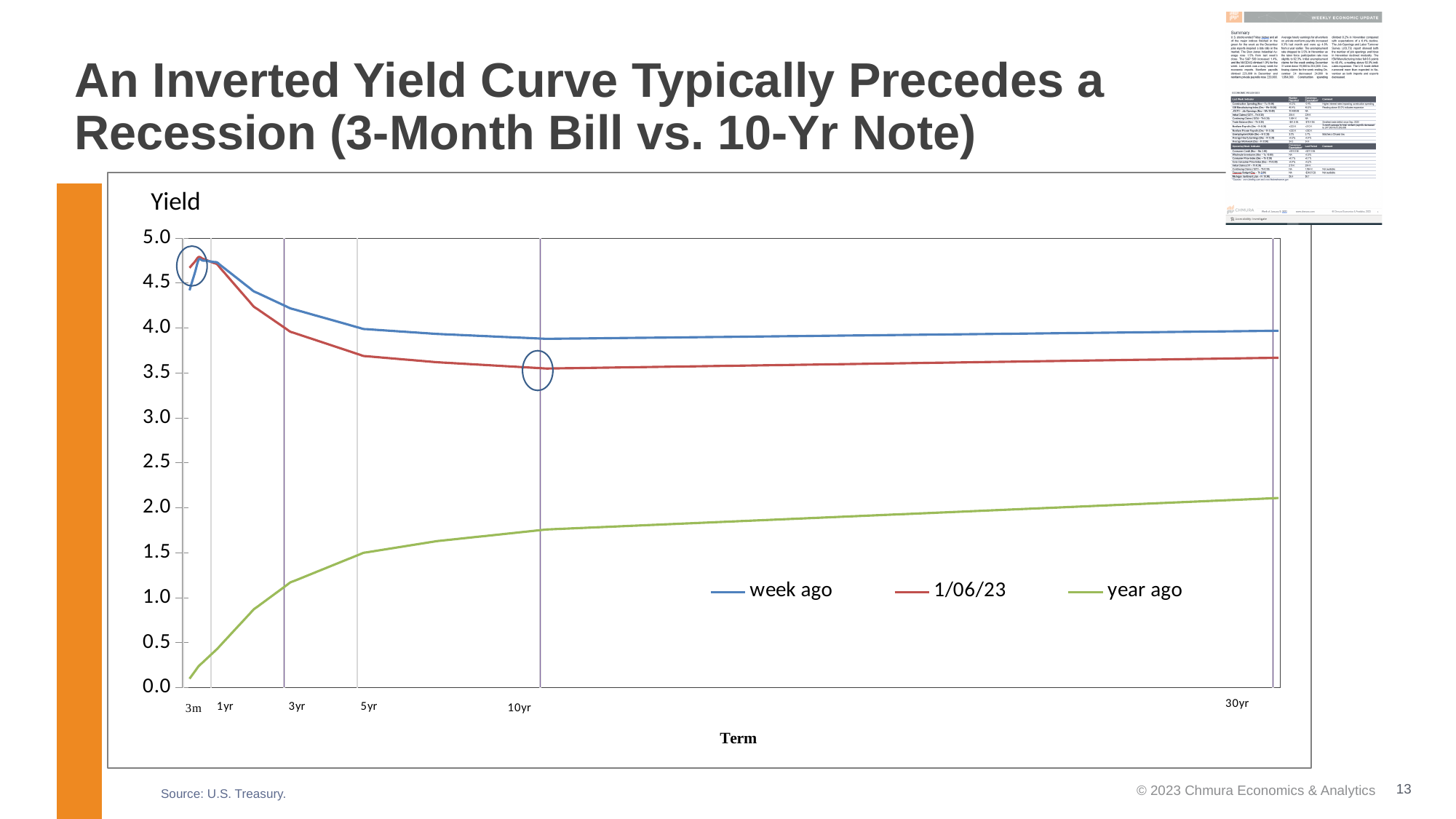
What is the label of the x axis? Term Does the year ago series rise or fall as the term increases from 3m to 30yr? rise How many term labels are shown along the x axis? 6 Is the value for the year ago series at 10yr greater or less than 2.0? less What kind of chart is shown on the slide? line chart Which series has the lowest yield across the whole term range? year ago Is the value for the week ago series at 3yr greater or less than 4.0? greater Is the value for the 1/06/23 series at 5yr greater or less than 4.0? less How many series does the legend list? 3 What are the three series named in the legend? week ago, 1/06/23, year ago At 10yr, which series has the higher yield: week ago or 1/06/23? week ago